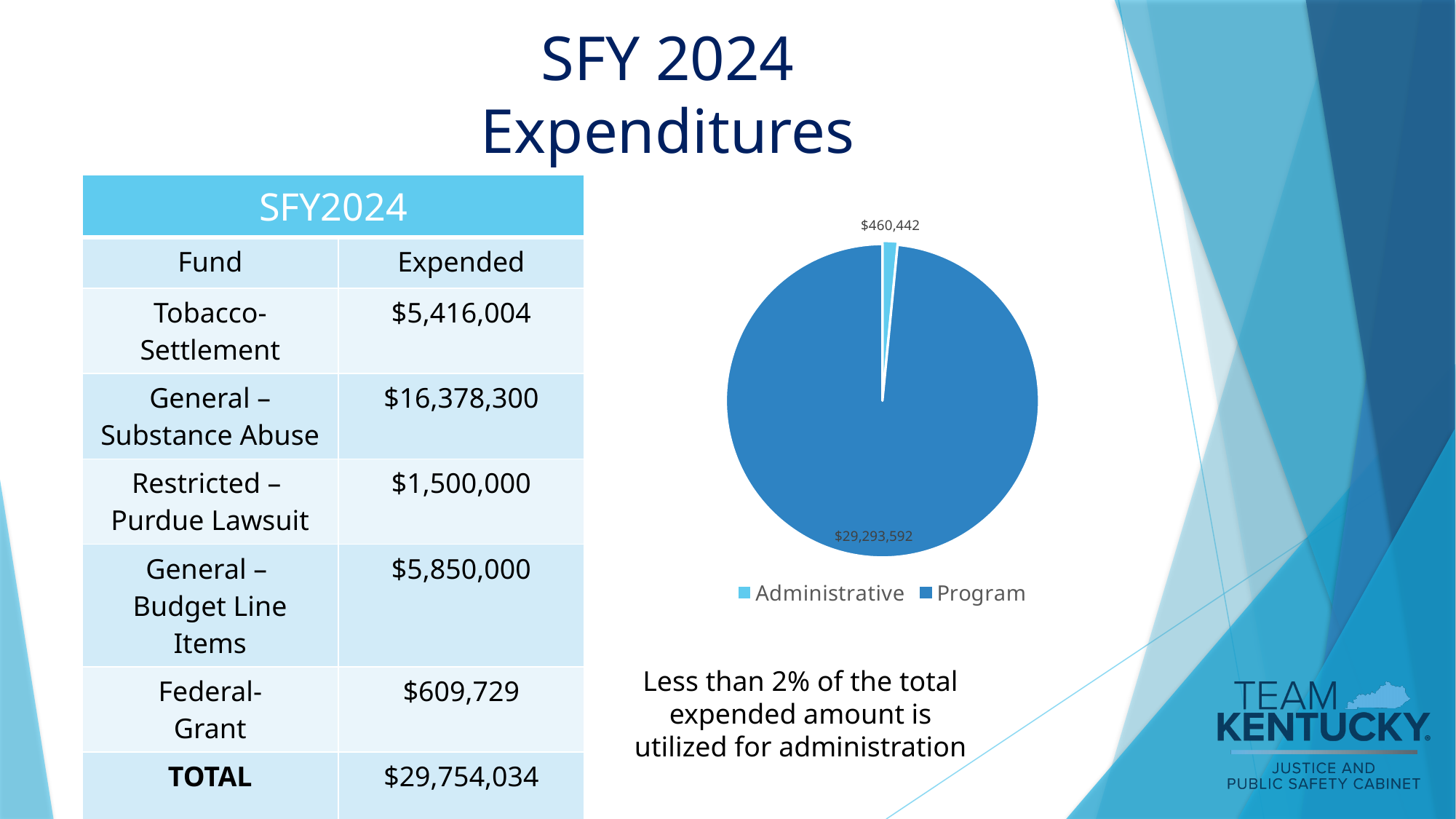
What colour is the Administrative slice in the pie chart? light blue Which slice of the pie chart is the smallest? Administrative What is the value of the Program slice in the pie chart? $29,293,592 Which slice of the pie chart is the largest? Program How many slices does the pie chart have? 2 What type of chart is shown on the slide? pie chart What is the value of the Administrative slice in the pie chart? $460,442 What is the difference between the Program and Administrative values in the pie chart? $28,833,150 How many entries does the pie chart legend list? 2 Which is larger in the pie chart, Administrative or Program? Program What is the total of the two slices in the pie chart? $29,754,034 Is the Administrative slice more or less than 2% of the pie chart total? less